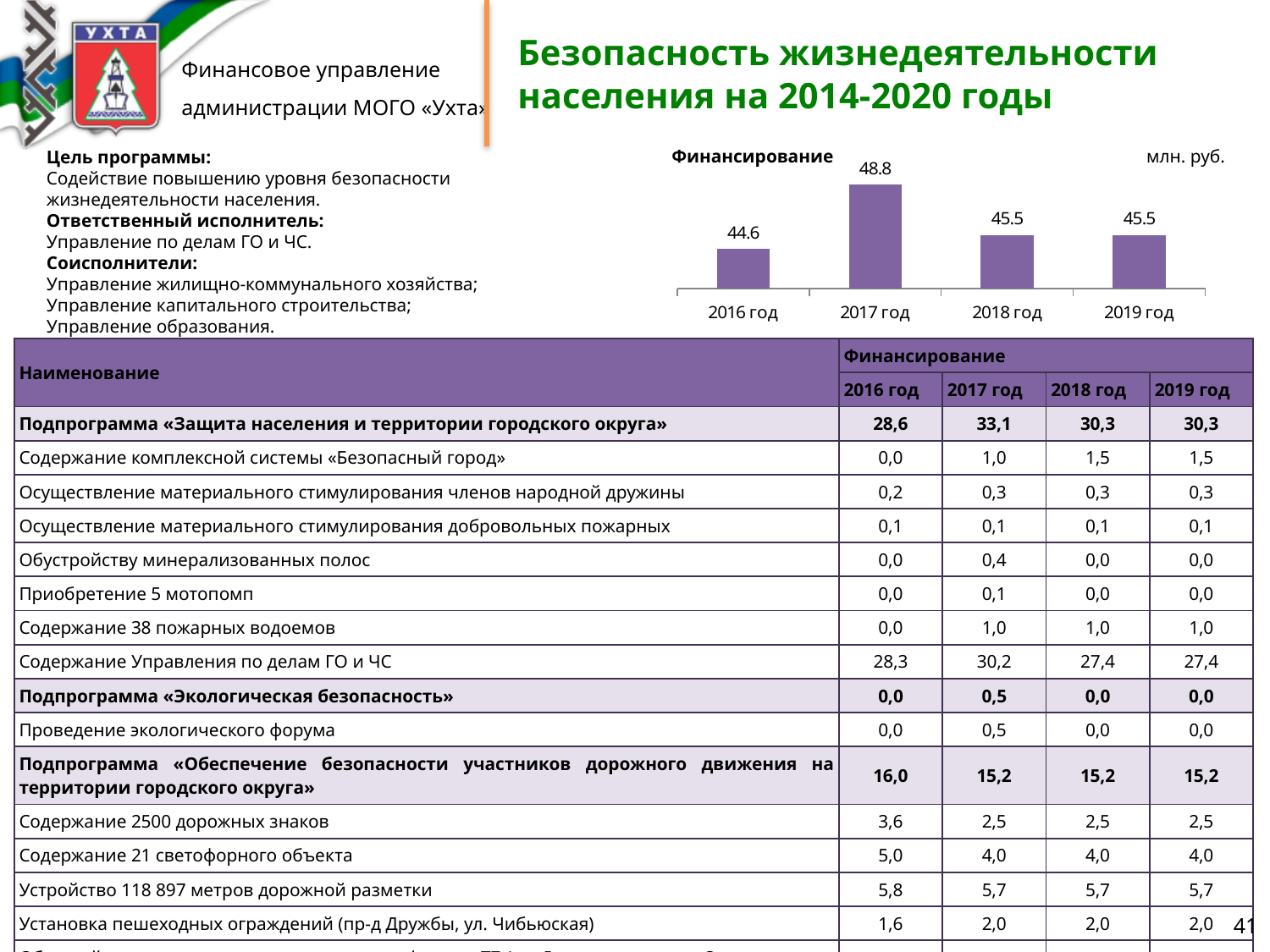
What is the value for 2018 год in the Финансирование chart? 45.5 What is the value for 2017 год in the Финансирование chart? 48.8 What unit is indicated for the values in the Финансирование chart? млн. руб. What is the value for 2019 год in the Финансирование chart? 45.5 Which year has the highest value in the Финансирование chart? 2017 год What is the value for 2016 год in the Финансирование chart? 44.6 What is the difference between the values for 2017 год and 2018 год in the Финансирование chart? 3.3 Which year has the lowest value in the Финансирование chart? 2016 год What is the difference between the values for 2017 год and 2016 год in the Финансирование chart? 4.2 In the Финансирование chart, which is larger: the value for 2018 год or the value for 2016 год? 2018 год How many years are shown in the Финансирование chart? 4 What type of chart is the Финансирование chart? bar chart